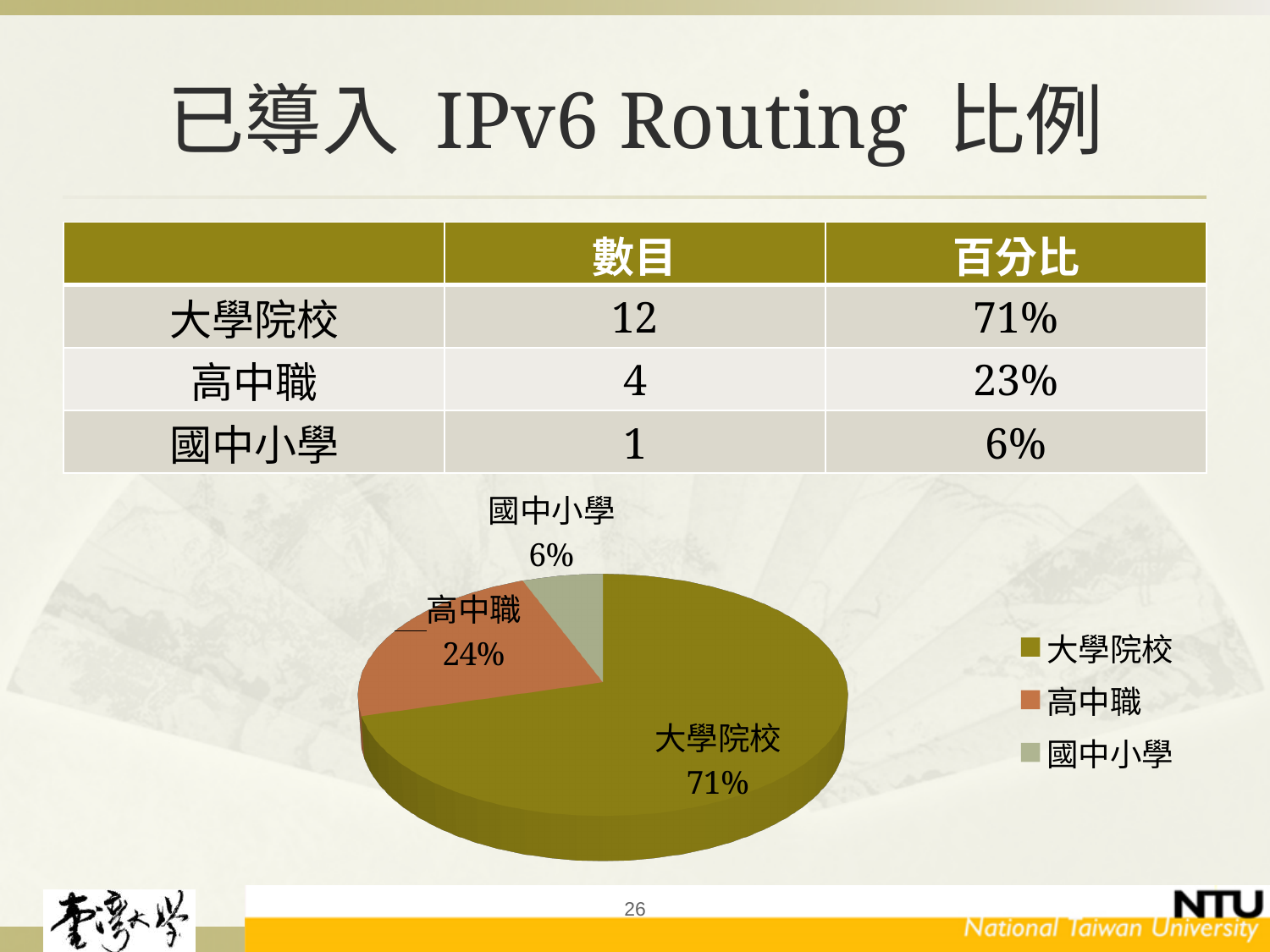
According to the pie chart labels, what is the difference in percentage points between 大學院校 and 高中職? 47 Which category has the smallest slice in the pie chart? 國中小學 Which category has the largest slice in the pie chart? 大學院校 In the pie chart, which slice is larger, 高中職 or 國中小學? 高中職 What percentage does the pie chart show for 大學院校? 71% What percentage does the pie chart show for 高中職? 24% What kind of chart is shown on the slide? pie chart What percentage does the pie chart show for 國中小學? 6% How many slices does the pie chart have? 3 How many entries does the pie chart's legend list? 3 Which legend entry is shown in the orange-brown colour in the pie chart? 高中職 What share of the pie does the 國中小學 slice represent? 6%